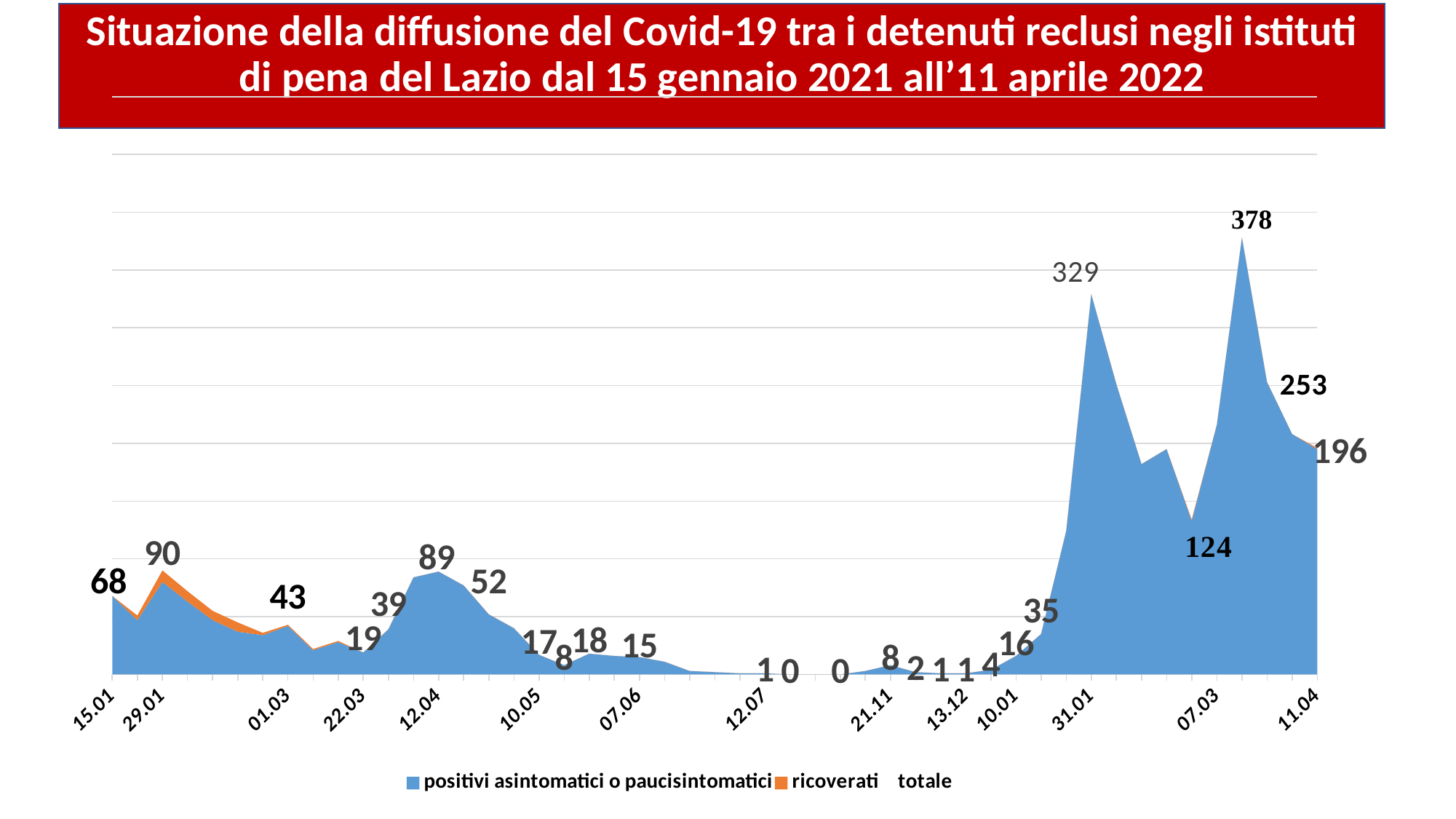
What is the value labelled at 15.01, the first date on the x axis? 68 Which colour represents the 'ricoverati' series in the legend? orange How many series does the legend list? 3 What is the value labelled at 31.01? 329 What is the value labelled at 11.04, the last date on the x axis? 196 What is the difference between the peak value of 378 and the value at 31.01? 49 Do the values rise or fall between 31.01 and 07.03? fall What kind of chart is shown on the slide? area chart What is the value labelled at 29.01? 90 What is the highest value labelled on the chart? 378 Which is larger, the value at 31.01 or the peak value labelled 378? 378